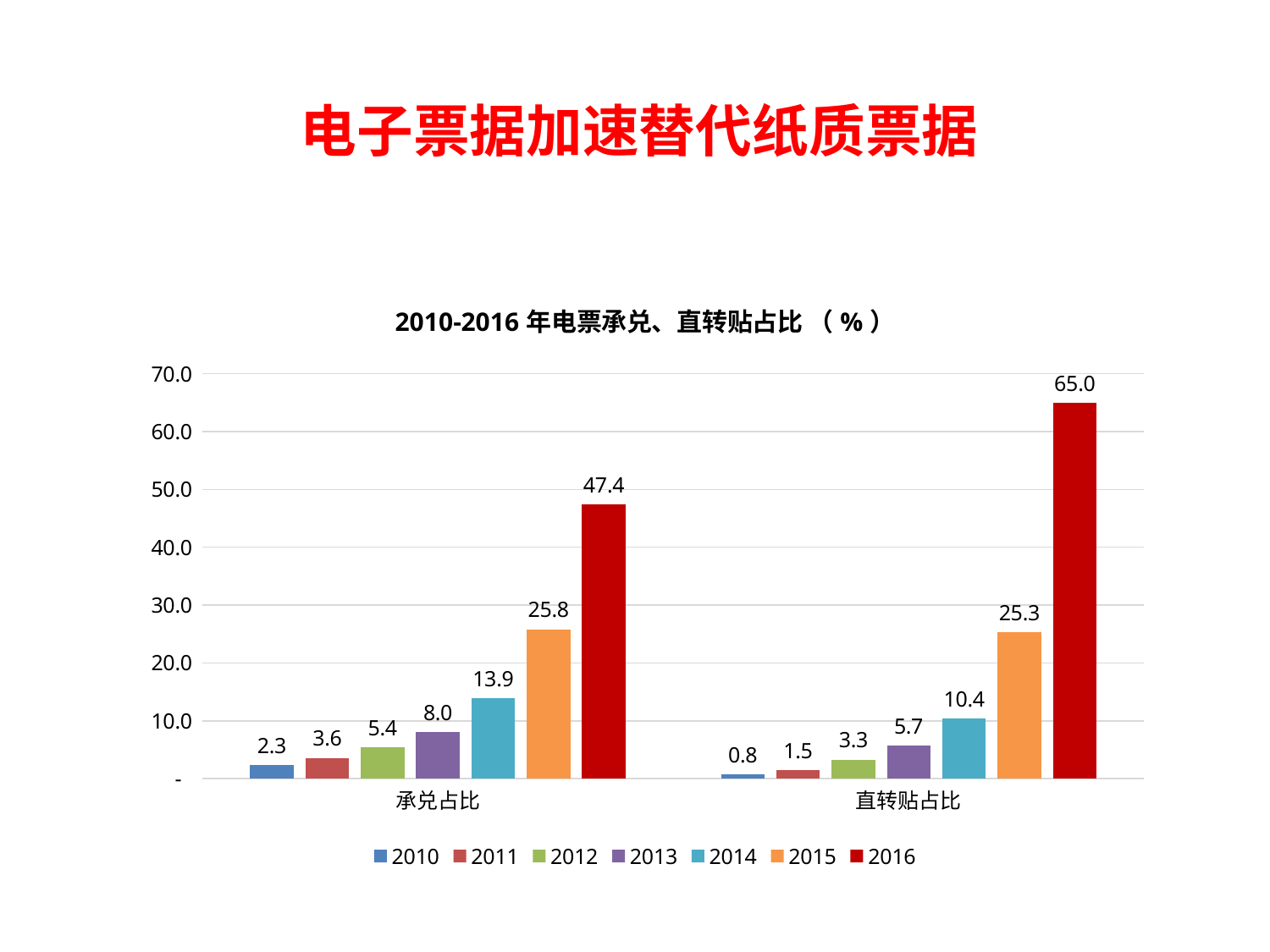
Within the 承兑占比 category, do the values rise or fall from 2010 to 2016? Rise What is the value for 2014 in the 直转贴占比 category? 10.4 What is the title of the chart? 2010-2016 年电票承兑、直转贴占比 （%） How many categories are shown on the x axis? 2 What is the value for 2016 in the 承兑占比 category? 47.4 What is the difference between the 2016 values for 直转贴占比 and 承兑占比? 17.6 Which year has the highest value in the 直转贴占比 category? 2016 What kind of chart is shown on the slide? Bar chart How many series does the legend list? 7 Which is larger: the 2015 value for 承兑占比 or the 2015 value for 直转贴占比? 承兑占比 What is the value for 2010 in the 直转贴占比 category? 0.8 Which year has the lowest value in the 承兑占比 category? 2010